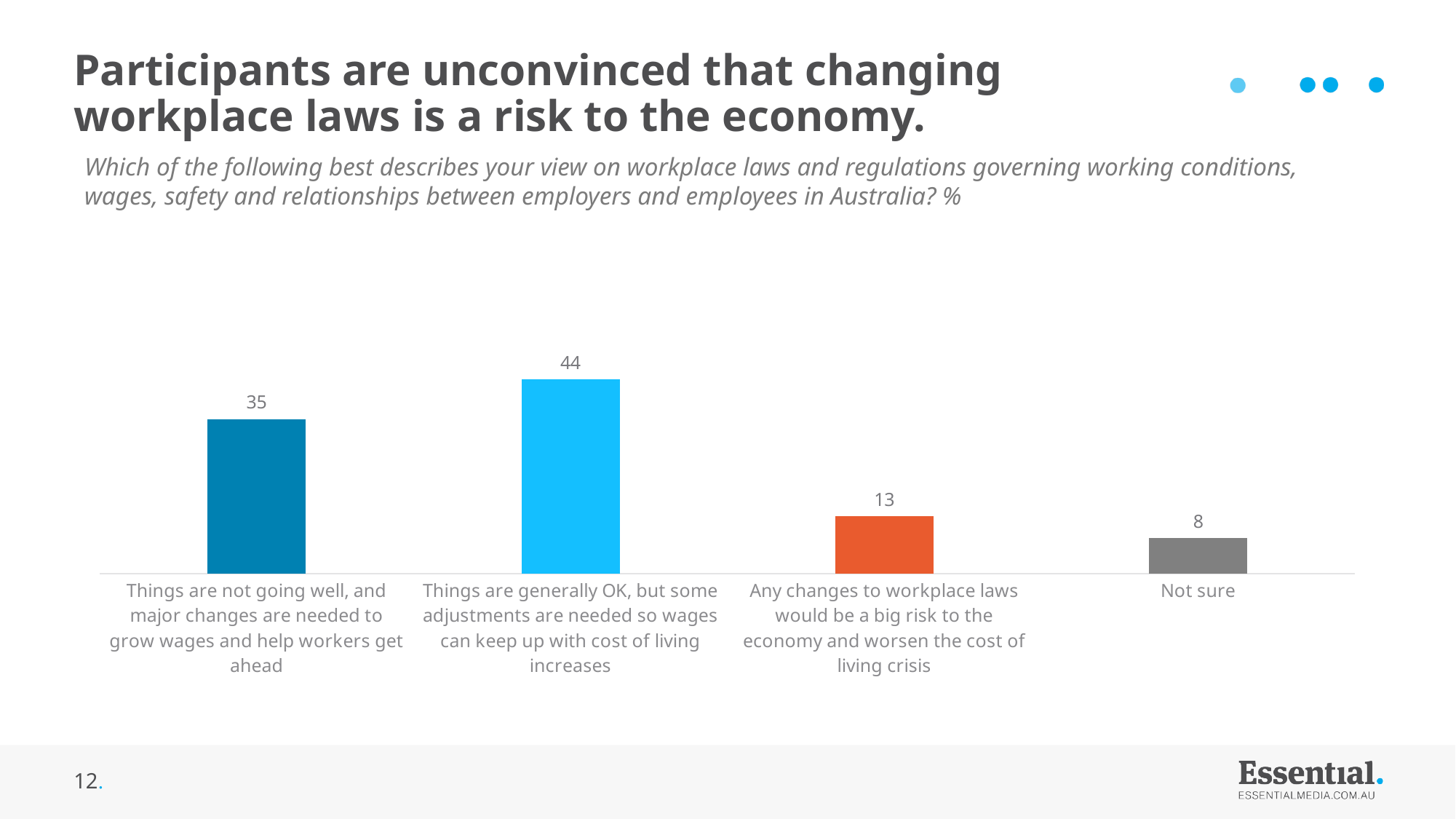
What kind of chart is shown on the slide? Bar chart What is the difference between the value for "Things are generally OK, but some adjustments are needed..." and the value for "Things are not going well, and major changes are needed..."? 9 What is the value for "Not sure"? 8 Which category has the highest value? Things are generally OK, but some adjustments are needed so wages can keep up with cost of living increases What is the value for "Things are not going well, and major changes are needed to grow wages and help workers get ahead"? 35 Which category has the lowest value? Not sure Which is larger: the value for "Things are not going well, and major changes are needed..." or the value for "Any changes to workplace laws would be a big risk to the economy..."? Things are not going well, and major changes are needed to grow wages and help workers get ahead What is the value for "Any changes to workplace laws would be a big risk to the economy and worsen the cost of living crisis"? 13 How many categories are shown in the chart? 4 What colour is the bar for "Any changes to workplace laws would be a big risk to the economy and worsen the cost of living crisis"? Orange What is the value for "Things are generally OK, but some adjustments are needed so wages can keep up with cost of living increases"? 44 What is the difference between the value for "Any changes to workplace laws would be a big risk to the economy..." and the value for "Not sure"? 5